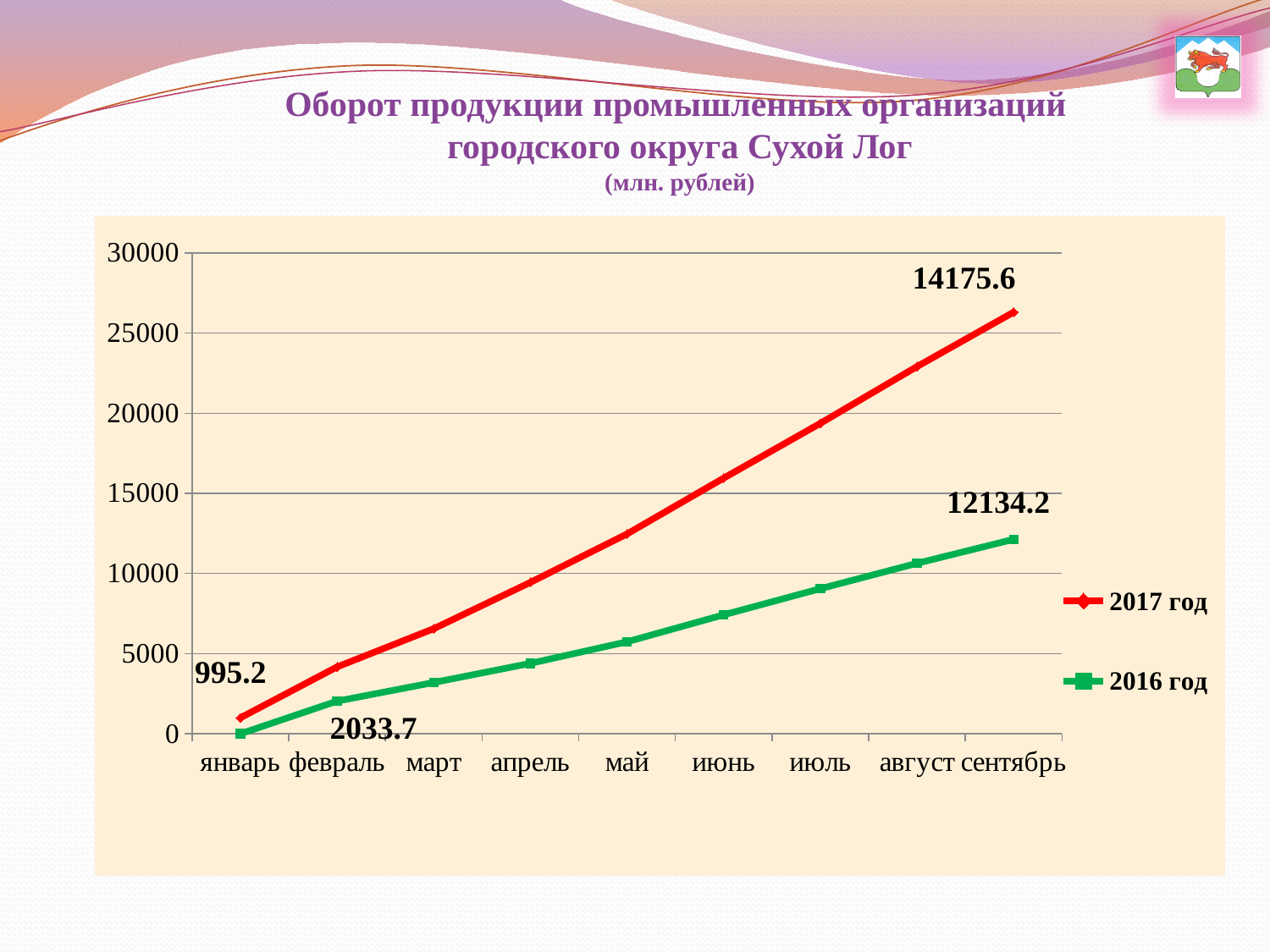
How many months are shown along the x axis? 9 Do the values of the 2016 год series rise or fall from January to September? rise Which colour is used for the 2017 год series? red Which series has the higher value in September, 2017 год or 2016 год? 2017 год What is the data label shown for January on the 2017 год series? 995.2 What is the data label shown for February on the 2016 год series? 2033.7 What type of chart is shown on the slide? line chart How many series does the legend list? 2 Is the value for May on the 2016 год series greater or less than 10000? less What is the data label shown for September on the 2016 год series? 12134.2